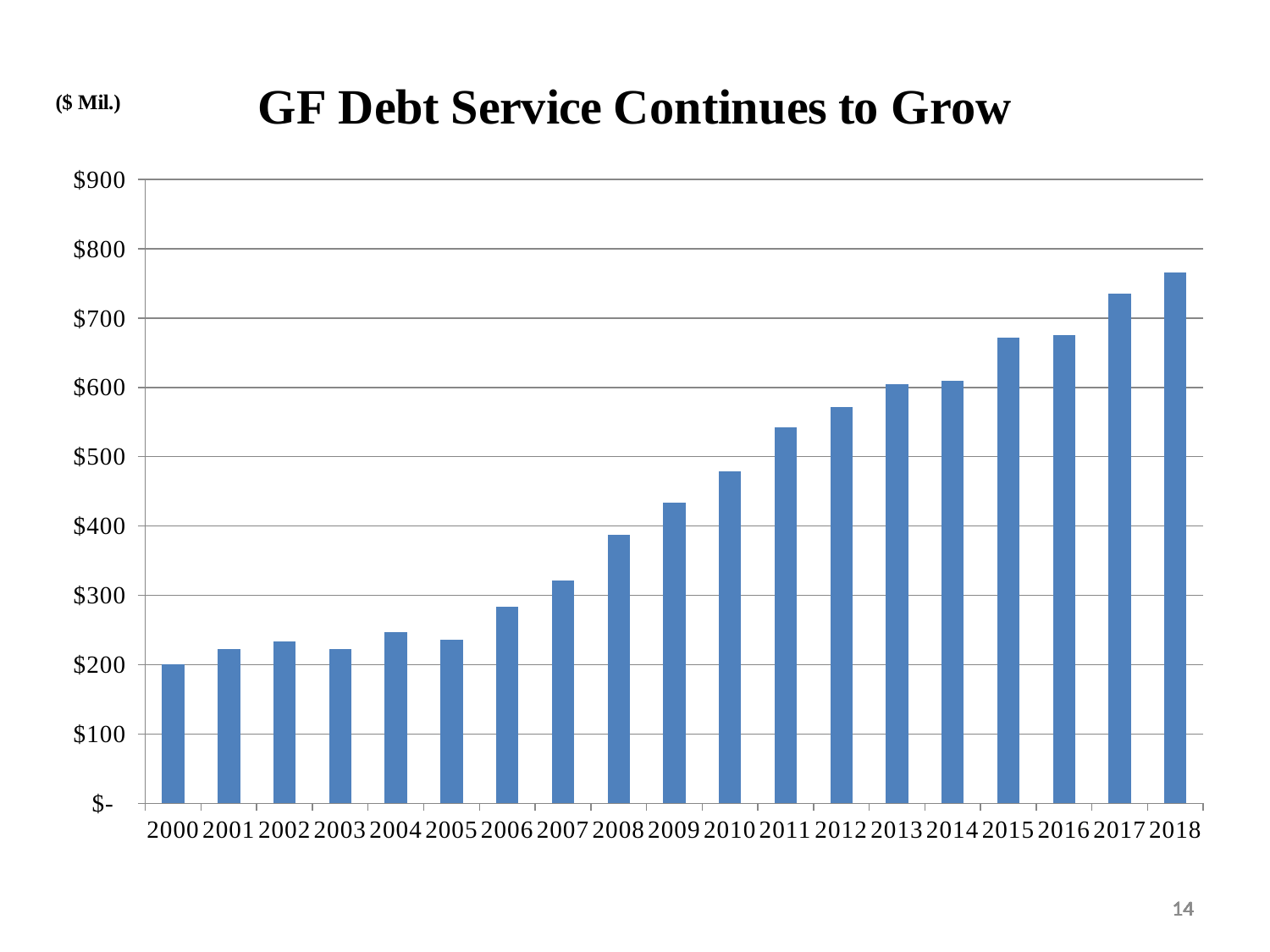
What kind of chart is shown on the slide? bar chart Is the value for 2010 greater or less than $500? less Is the value for 2018 greater or less than $700? greater Is the value for 2008 greater or less than $400? less Do the values generally rise or fall from 2000 to 2018? rise Which year has the lowest GF debt service? 2000 What is the title of the chart? GF Debt Service Continues to Grow Which year has the highest GF debt service? 2018 Which is larger, the value for 2012 or the value for 2009? 2012 What unit is indicated for the values on the chart? $ Mil. How many years are plotted on the x axis? 19